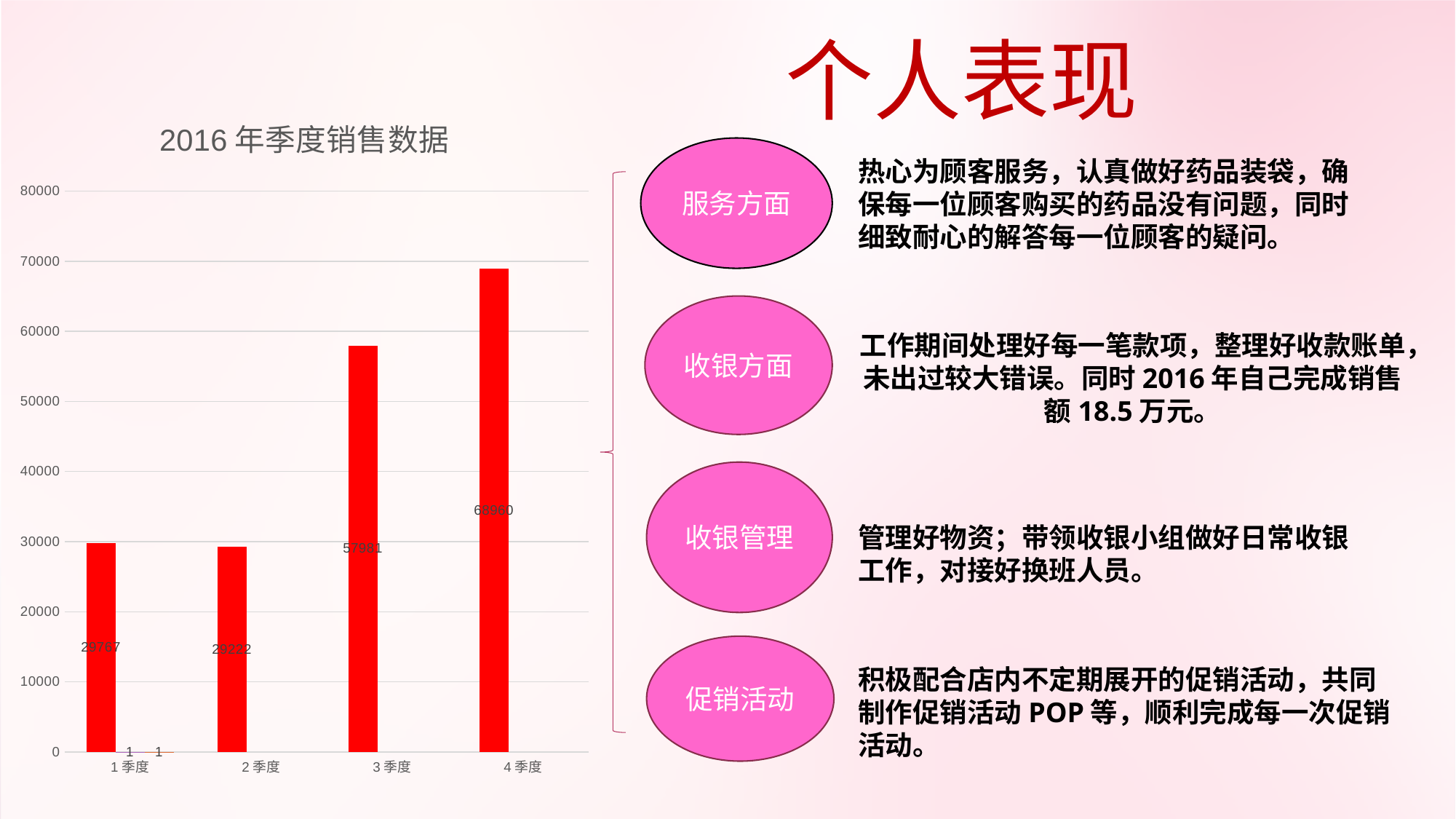
What is the value for 4 季度 in the 2016 年季度销售数据 chart? 68960 What is the title of the chart on the slide? 2016 年季度销售数据 What kind of chart is the 2016 年季度销售数据 chart? bar chart Is the value for 4 季度 in the 2016 年季度销售数据 chart greater or less than 60000? greater Which is larger in the 2016 年季度销售数据 chart, the value for 3 季度 or the value for 2 季度? 3 季度 What is the value for 2 季度 in the 2016 年季度销售数据 chart? 29222 Which quarter has the lowest value in the 2016 年季度销售数据 chart? 2 季度 Which quarter has the highest value in the 2016 年季度销售数据 chart? 4 季度 What is the difference between the values for 4 季度 and 3 季度 in the 2016 年季度销售数据 chart? 10979 What is the value for 1 季度 in the 2016 年季度销售数据 chart? 29767 What is the value for 3 季度 in the 2016 年季度销售数据 chart? 57981 How many quarters are shown on the x axis of the 2016 年季度销售数据 chart? 4